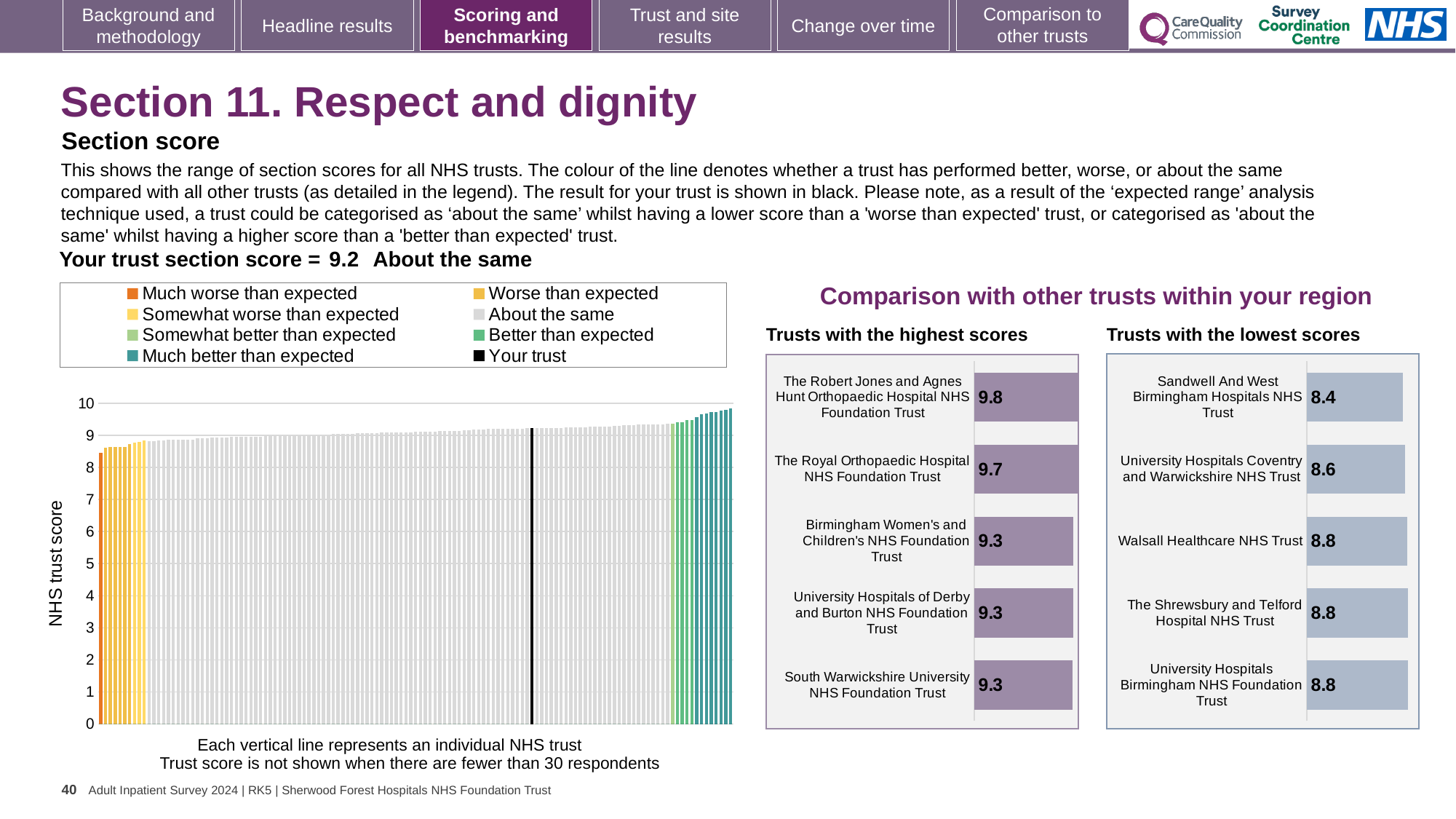
In the 'Trusts with the lowest scores' chart, what is the difference between the scores of University Hospitals Coventry and Warwickshire NHS Trust and Sandwell And West Birmingham Hospitals NHS Trust? 0.2 In the main section score chart on the left, what is the label of the vertical axis? NHS trust score In the 'Trusts with the lowest scores' chart, what is the score for Sandwell And West Birmingham Hospitals NHS Trust? 8.4 In the main section score chart on the left, how many entries does the legend list? 8 What type of chart is the main section score chart on the left? Bar chart In the main section score chart on the left, is the value for the black 'Your trust' bar greater or less than 9? greater In the 'Trusts with the highest scores' chart, which trust has the highest score? The Robert Jones and Agnes Hunt Orthopaedic Hospital NHS Foundation Trust In the 'Trusts with the lowest scores' chart, which has the higher score: Walsall Healthcare NHS Trust or University Hospitals Coventry and Warwickshire NHS Trust? Walsall Healthcare NHS Trust In the 'Trusts with the lowest scores' chart, which trust has the lowest score? Sandwell And West Birmingham Hospitals NHS Trust In the 'Trusts with the highest scores' chart, what is the score for The Robert Jones and Agnes Hunt Orthopaedic Hospital NHS Foundation Trust? 9.8 In the 'Trusts with the highest scores' chart, what is the score for The Royal Orthopaedic Hospital NHS Foundation Trust? 9.7 In the 'Trusts with the highest scores' chart, how many trusts are shown? 5